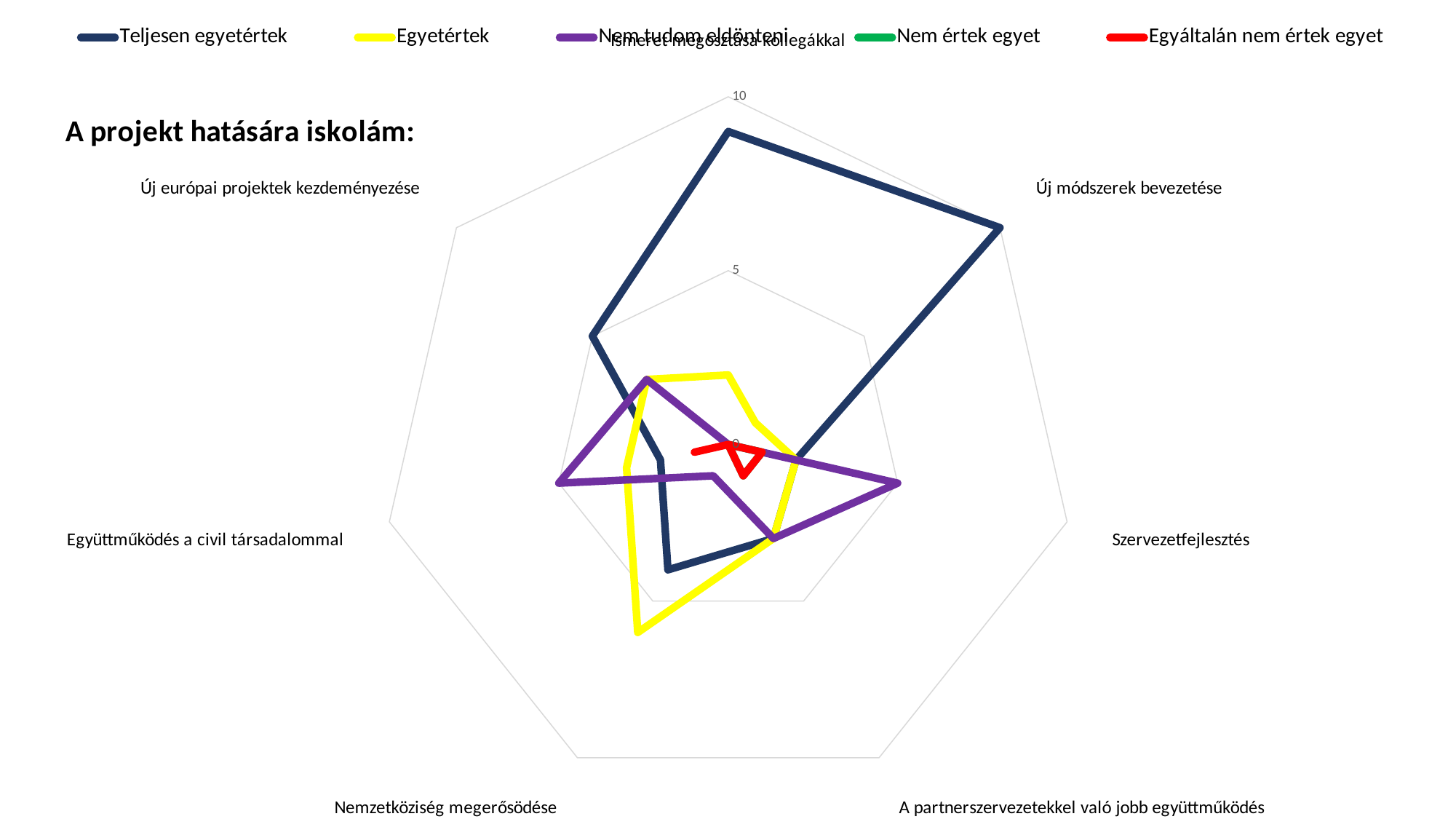
What kind of chart is shown on the slide? Radar chart How many series does the legend list? 5 For the 'Teljesen egyetértek' series, which is larger: the value for 'Új módszerek bevezetése' or for 'Szervezetfejlesztés'? Új módszerek bevezetése Is the 'Teljesen egyetértek' value for 'Nemzetköziség megerősödése' greater or less than 5? less Is the 'Teljesen egyetértek' value for 'Ismeret megosztása kollegákkal' greater or less than 5? greater Is the 'Teljesen egyetértek' value for 'Szervezetfejlesztés' greater or less than 5? less For 'Nemzetköziség megerősödése', which series has the larger value: 'Egyetértek' or 'Teljesen egyetértek'? Egyetértek What is the title of the chart? A projekt hatására iskolám: How many categories (axes) does the radar chart have? 7 Which colour represents the 'Egyetértek' series? Yellow